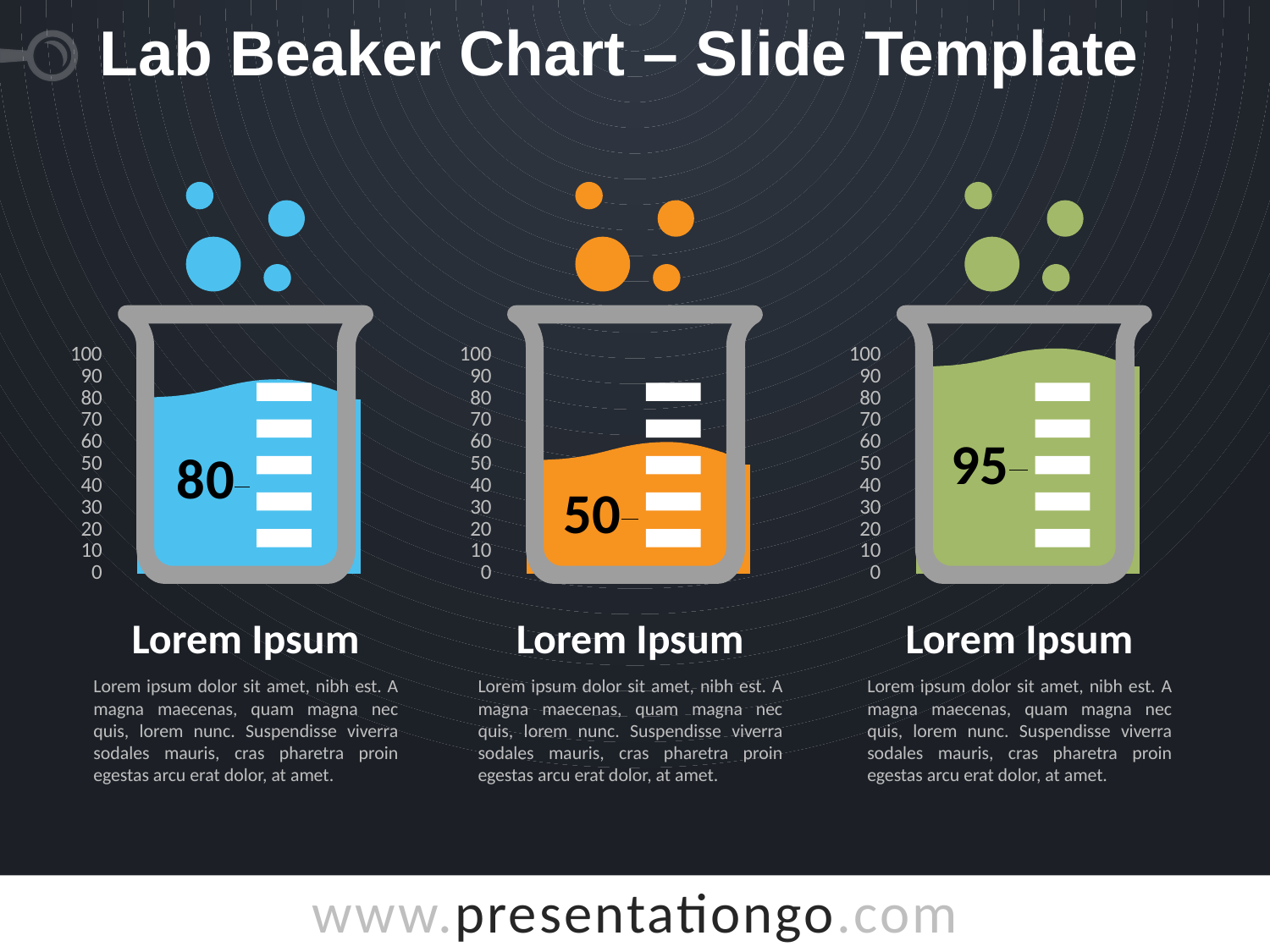
Which of the three beaker charts shows the highest value? The right (green) beaker What is the maximum value marked on the scale of each beaker chart? 100 What is the difference between the value in the right (green) beaker and the value in the middle (orange) beaker? 45 Which of the three beaker charts shows the lowest value? The middle (orange) beaker Is the value in the middle (orange) beaker greater or less than 60? less What value is shown in the left (blue) beaker chart? 80 Which is larger, the value in the left (blue) beaker or the value in the right (green) beaker? The right (green) beaker What value is shown in the right (green) beaker chart? 95 What is the difference between the value in the left (blue) beaker and the value in the middle (orange) beaker? 30 How many beaker charts are shown on the slide? 3 What value is shown in the middle (orange) beaker chart? 50 What is the title of the slide? Lab Beaker Chart – Slide Template